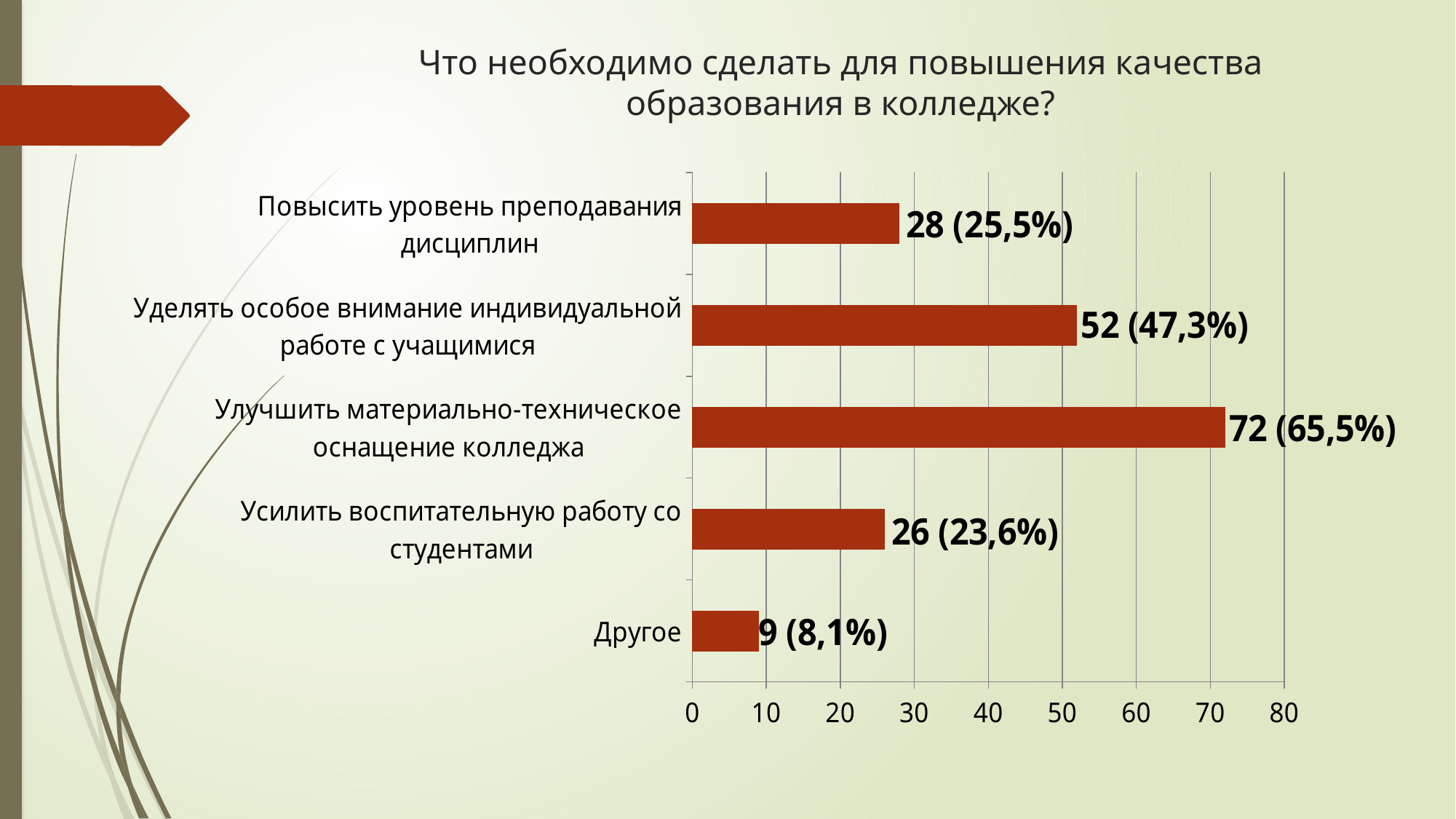
Is the value for "Уделять особое внимание индивидуальной работе с учащимися" greater or less than 40? greater Which category has the lowest value? Другое What kind of chart is shown on the slide? Bar chart What is the value for "Другое"? 9 (8,1%) What is the title of the slide? Что необходимо сделать для повышения качества образования в колледже? What is the value for "Уделять особое внимание индивидуальной работе с учащимися"? 52 (47,3%) How many categories are shown in the chart? 5 What is the difference in count between "Улучшить материально-техническое оснащение колледжа" and "Уделять особое внимание индивидуальной работе с учащимися"? 20 What is the difference in count between "Повысить уровень преподавания дисциплин" and "Усилить воспитательную работу со студентами"? 2 What is the value for "Улучшить материально-техническое оснащение колледжа"? 72 (65,5%) Which is larger: the value for "Повысить уровень преподавания дисциплин" or for "Усилить воспитательную работу со студентами"? Повысить уровень преподавания дисциплин Which category has the highest value? Улучшить материально-техническое оснащение колледжа